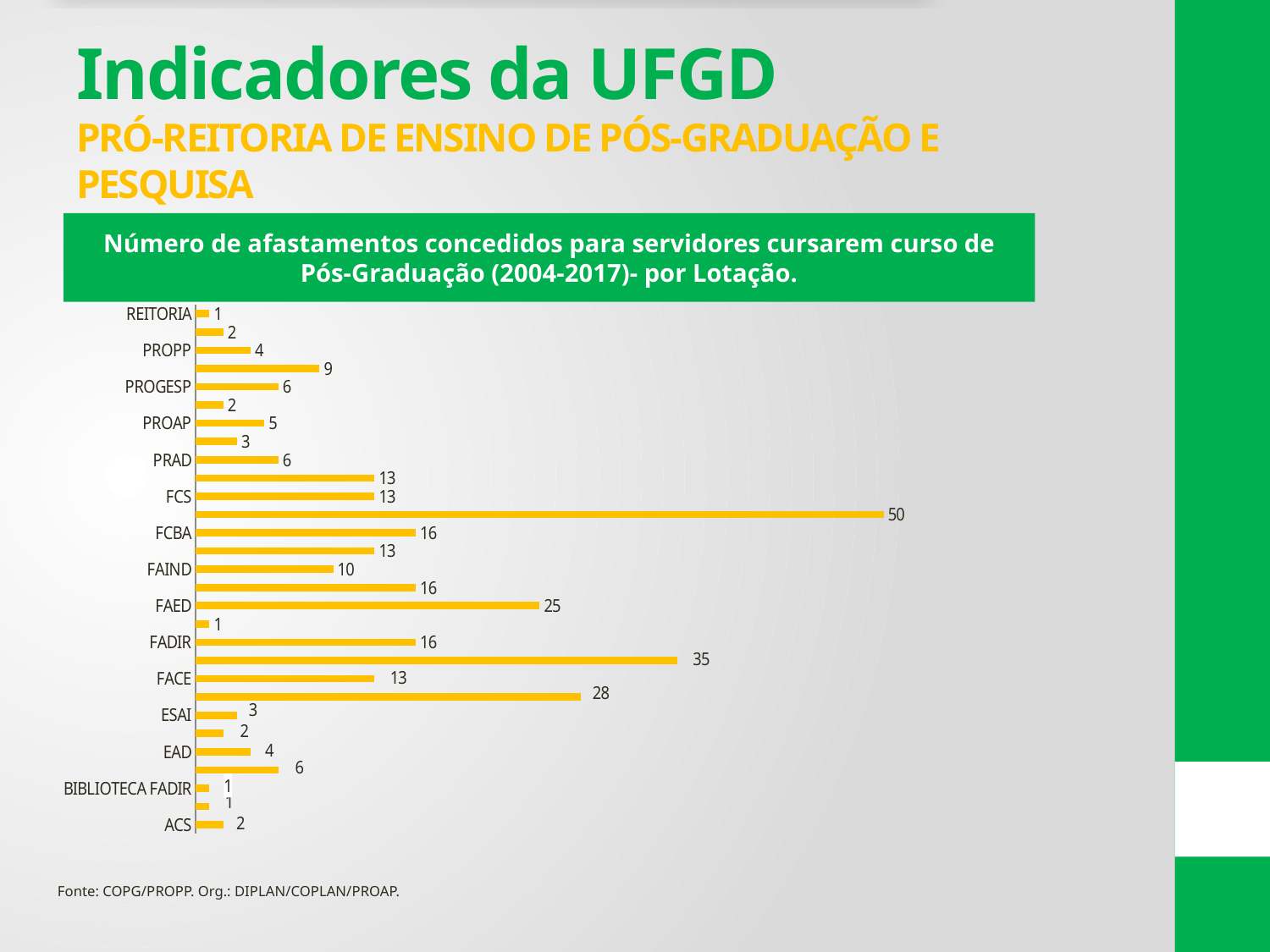
What is the value for FAED? 25 What is the largest value shown on the chart? 50 What is the value for FCBA? 16 How many bars are plotted on the chart? 29 What is the title of the chart? Número de afastamentos concedidos para servidores cursarem curso de Pós-Graduação (2004-2017)- por Lotação. Which has a larger value, FCBA or PRAD? FCBA What is the value for PROPP? 4 What is the value for ACS? 2 Which has a larger value, FAED or FACE? FAED What kind of chart is shown on the slide? Bar chart What is the difference between the values for FAED and FADIR? 9 What is the value for FAIND? 10